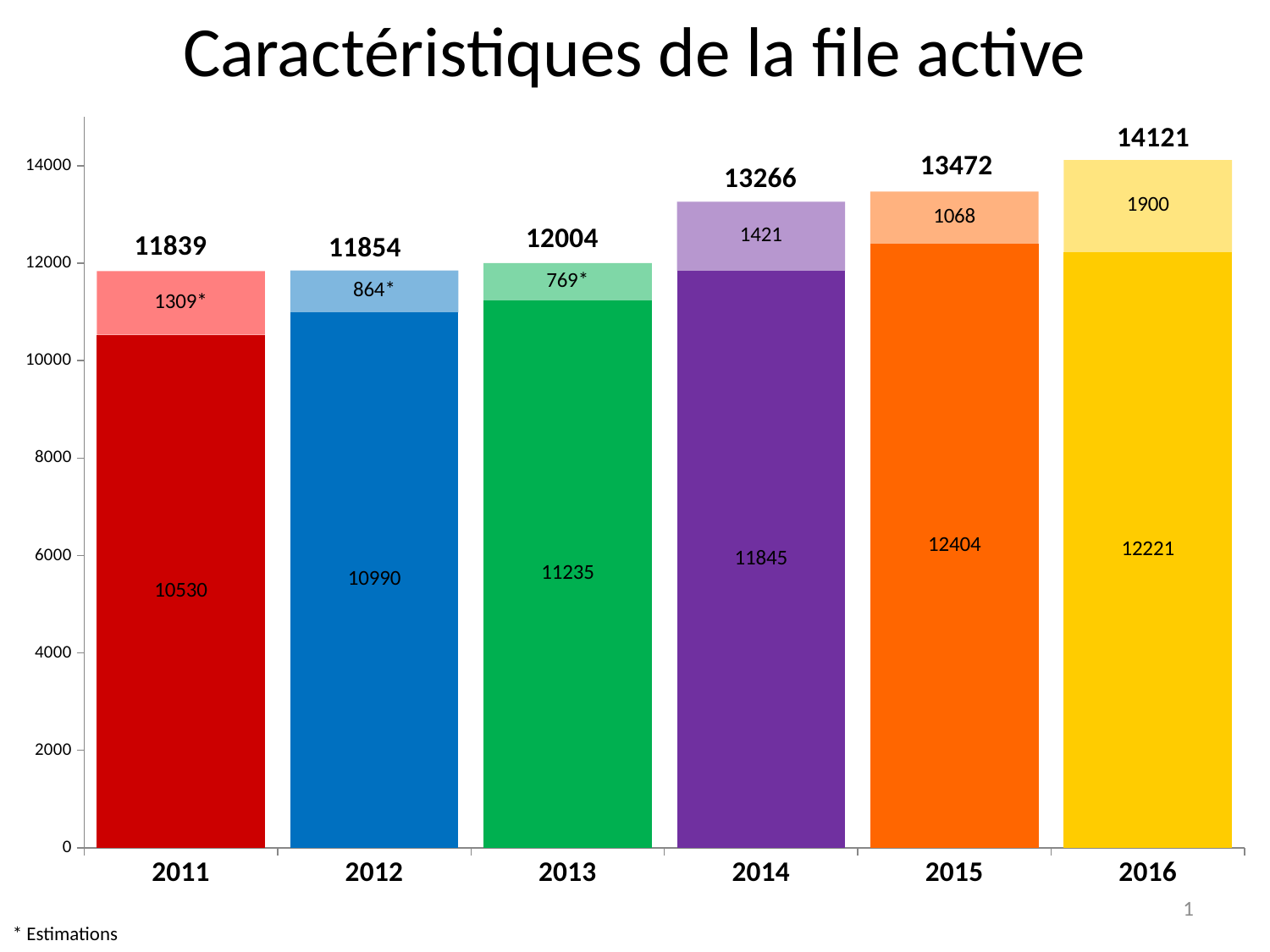
Is the total for 2014 greater or less than 12000? greater Which year has the lowest total? 2011 How many years are shown on the x axis? 6 What is the value of the bottom segment of the 2014 bar? 11845 What is the total value printed above the bar for 2016? 14121 What is the difference between the totals for 2016 and 2015? 649 What kind of chart is shown on the slide? Stacked bar chart Do the bar totals rise or fall from 2011 to 2016? Rise What is the value of the top segment of the 2011 bar? 1309* Which year has the highest total? 2016 Which is larger, the bottom segment for 2015 or the bottom segment for 2016? 2015 What is the value of the top segment of the 2015 bar? 1068